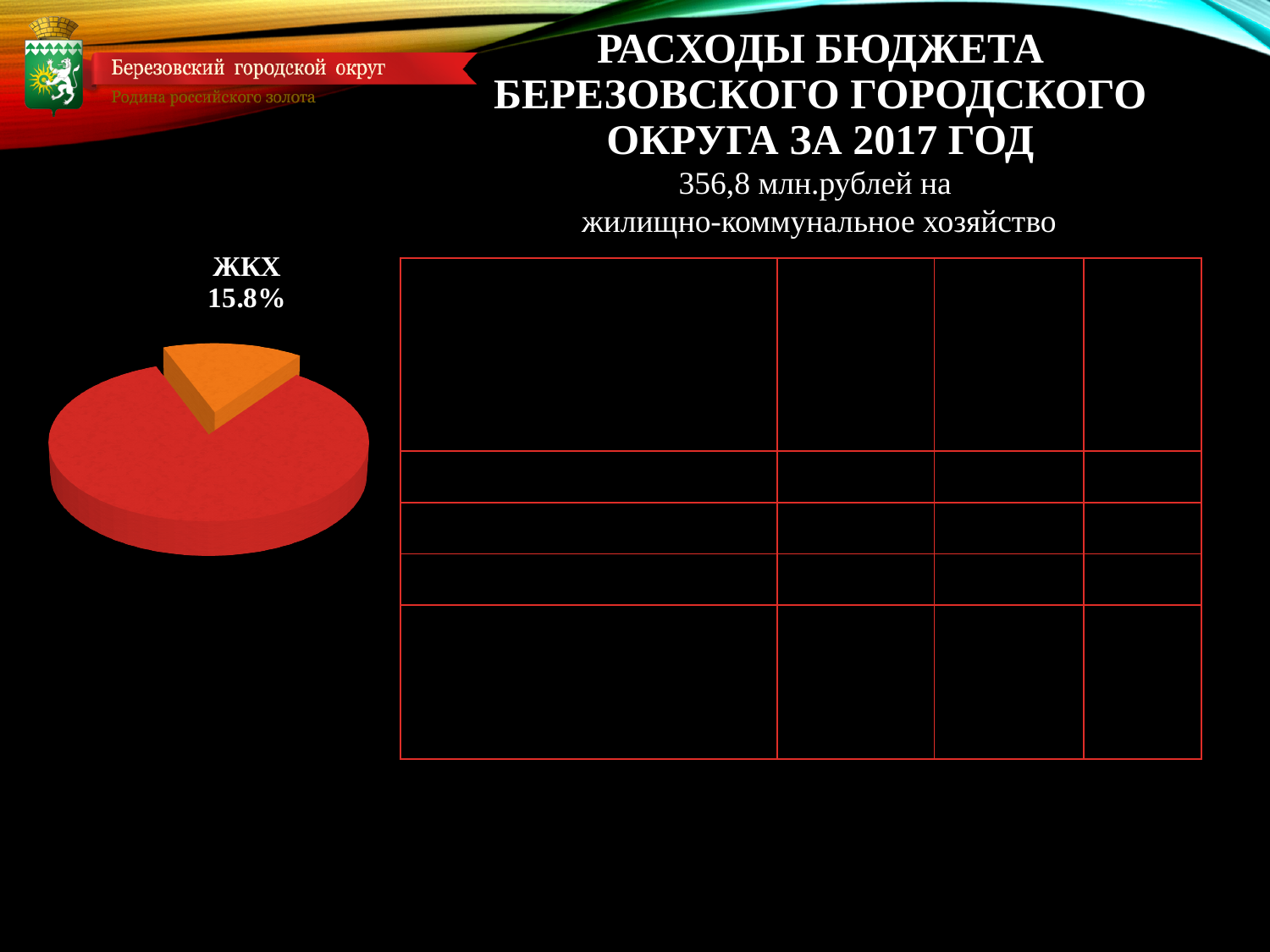
What kind of chart is shown on the slide? pie chart Which slice of the pie chart is pulled out from the rest of the pie? ЖКХ What share of the pie does the ЖКХ slice represent? 15.8% Which slice of the pie chart is larger, the ЖКХ slice or the red slice? the red slice What is the value printed for the ЖКХ slice of the pie chart? 15.8% Is the share of the ЖКХ slice greater or less than 20%? less Which slice of the pie chart is the smallest? ЖКХ What colour is the ЖКХ slice of the pie chart? orange How many slices does the pie chart have? 2